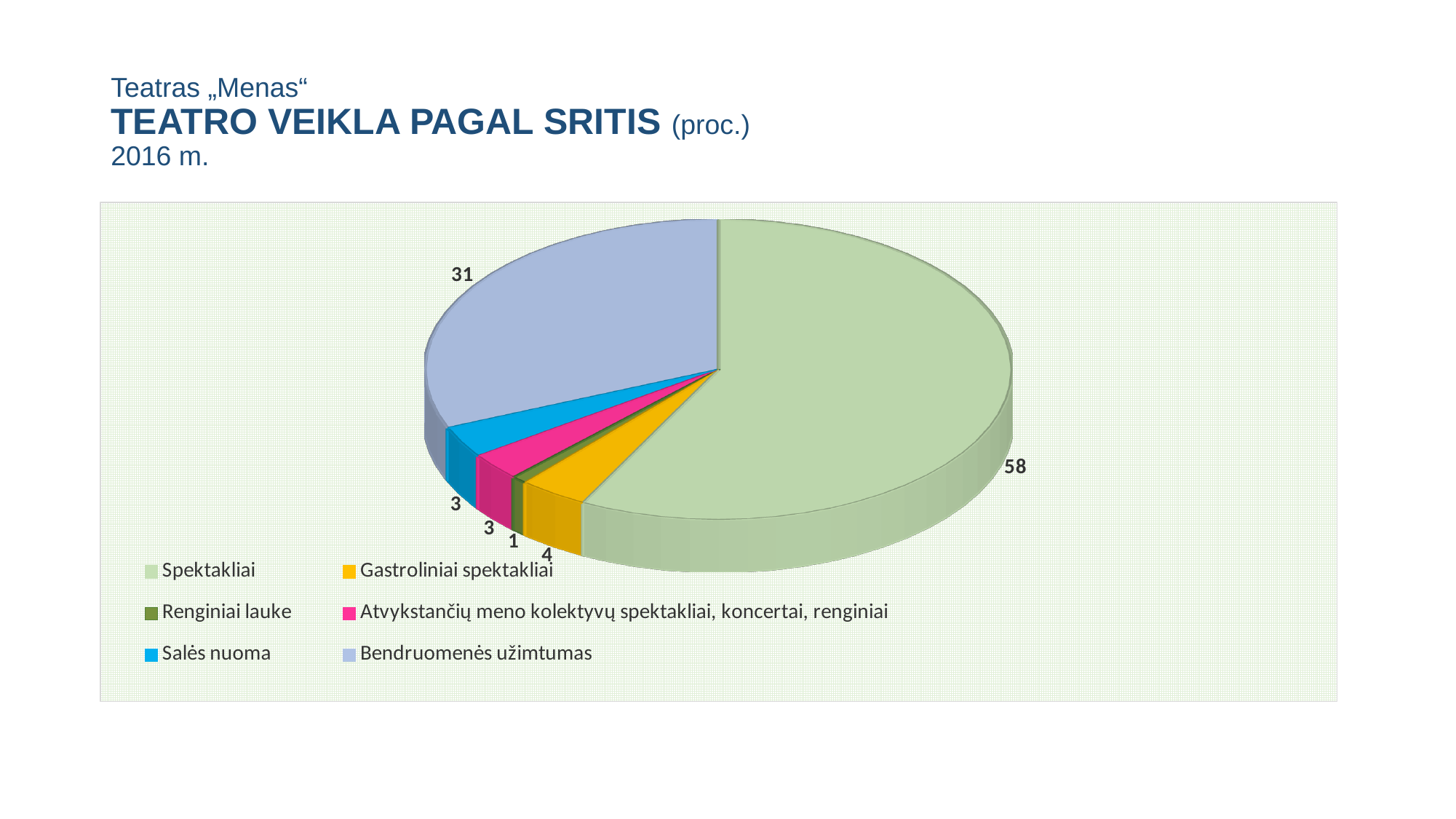
What kind of chart is shown on the slide? Pie chart What is the value for Bendruomenės užimtumas? 31 What is the value for Salės nuoma? 3 Which is larger, the value for Gastroliniai spektakliai or the value for Salės nuoma? Gastroliniai spektakliai Which category has the largest slice of the pie? Spektakliai Which category has the smallest slice of the pie? Renginiai lauke What is the value for Gastroliniai spektakliai? 4 What is the difference between the values for Spektakliai and Bendruomenės užimtumas? 27 What year is given in the chart title? 2016 m. How many categories does the pie chart show? 6 What is the value for Renginiai lauke? 1 What is the value for Spektakliai? 58